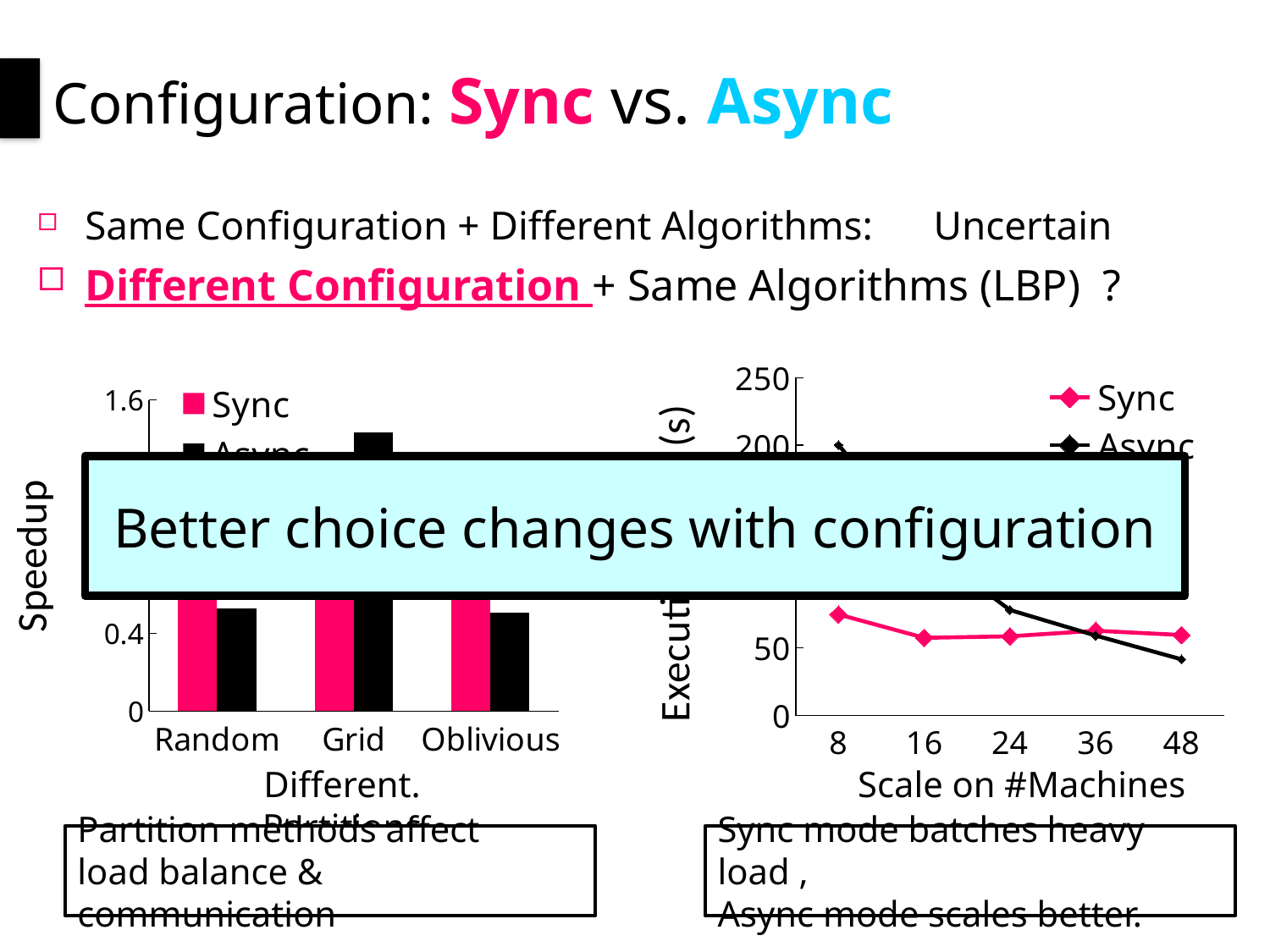
In the right chart (Scale on #Machines), does the Async line rise or fall as the number of machines increases? fall In the left chart (Speedup), how many series does the legend list? 2 In the left chart (Speedup), is the Async value for Random greater or less than 0.8? less In the right chart (Scale on #Machines), is the Async value at 8 machines greater or less than 150? greater In the right chart (Scale on #Machines), how many machine counts are shown on the x axis? 5 In the left chart (Speedup), how many partition method categories are shown on the x axis? 3 What is the y-axis label of the left chart? Speedup What kind of chart is the right chart (Scale on #Machines)? line chart In the right chart (Scale on #Machines), which series has the higher value at 8 machines, Sync or Async? Async In the left chart (Speedup), which partition method has the highest Async bar? Grid In the left chart (Speedup), is the Async value for Grid greater or less than 1.2? greater What kind of chart is the left chart (Speedup)? bar chart